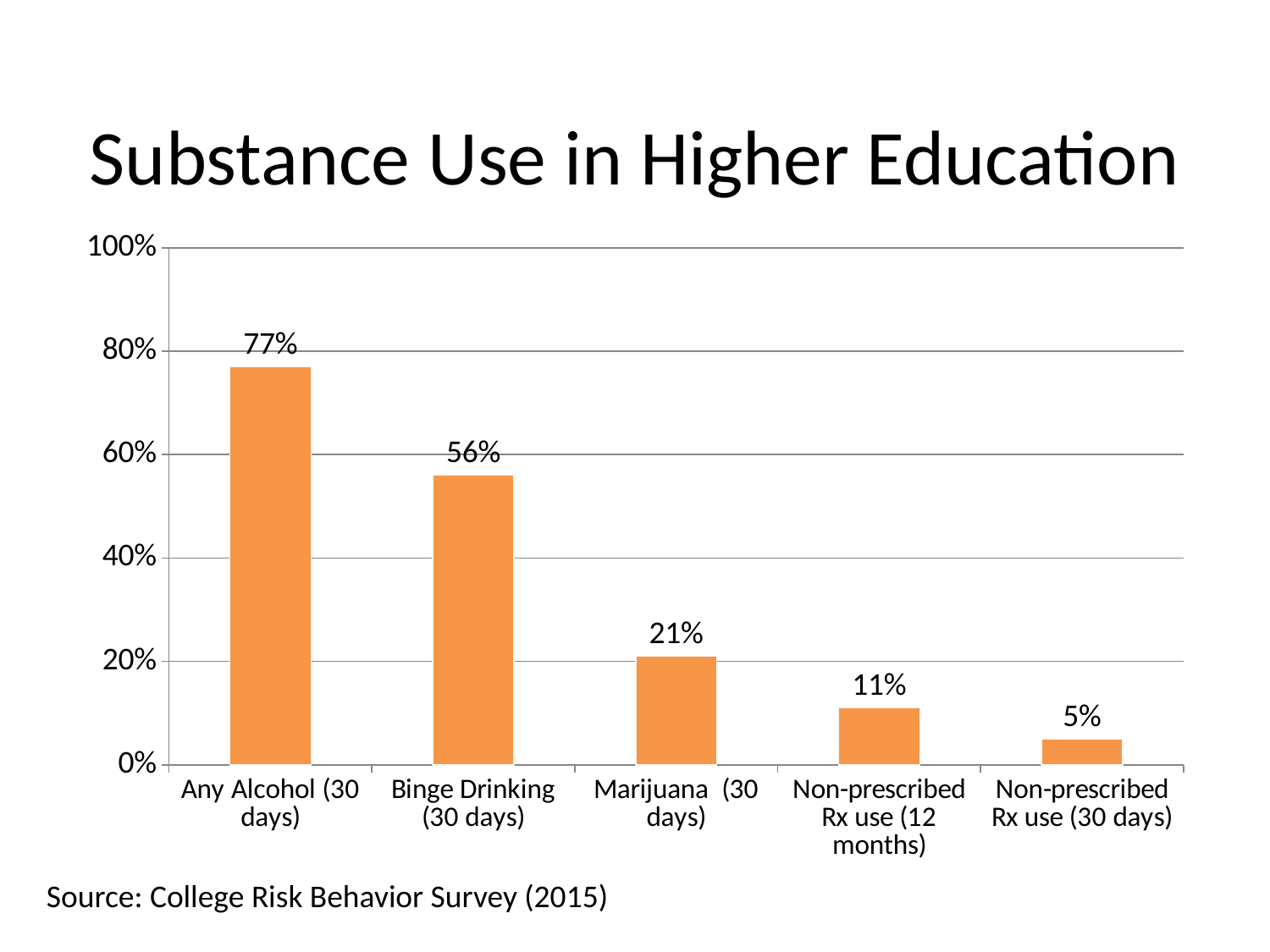
What is the source cited below the chart? College Risk Behavior Survey (2015) How many categories are shown in the chart? 5 What kind of chart is shown on the slide? Bar chart What is the value for Non-prescribed Rx use (30 days)? 5% What is the value for Any Alcohol (30 days)? 77% What is the difference between Any Alcohol (30 days) and Binge Drinking (30 days)? 21% What is the value for Non-prescribed Rx use (12 months)? 11% Which is larger, Marijuana (30 days) or Non-prescribed Rx use (12 months)? Marijuana (30 days) What is the value for Marijuana (30 days)? 21% What is the value for Binge Drinking (30 days)? 56% Which category has the lowest value? Non-prescribed Rx use (30 days) Which category has the highest value? Any Alcohol (30 days)